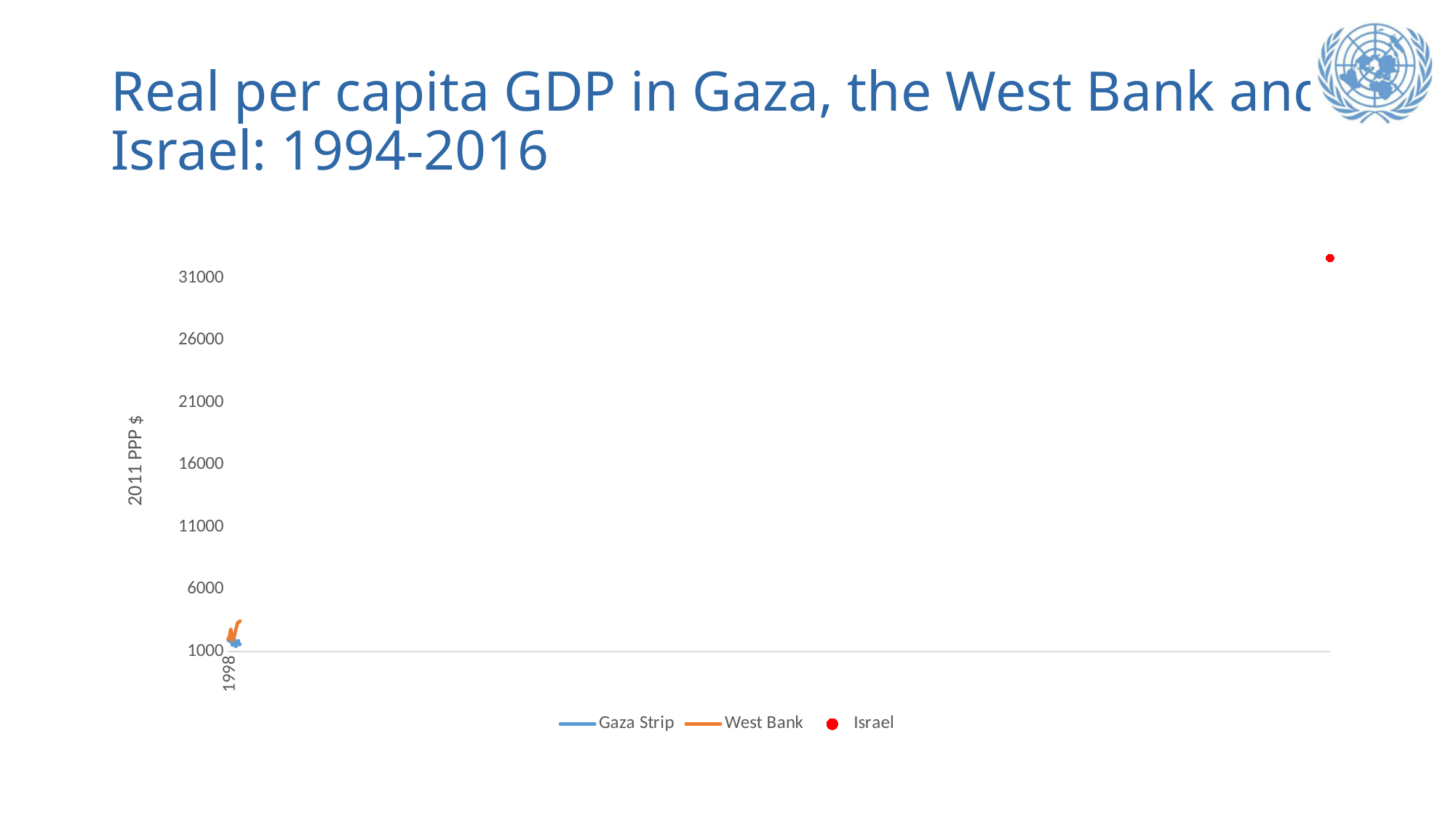
Which is larger, the plotted value for Israel or the plotted values for the West Bank? Israel Are the plotted values for the West Bank greater or less than 6000? less What is the highest tick value shown on the vertical axis? 31000 Is the plotted value for Israel greater or less than 26000? greater What is the label on the vertical axis? 2011 PPP $ Are the plotted values for the Gaza Strip greater or less than 6000? less How many series does the legend list? 3 Which series are listed in the legend? Gaza Strip, West Bank, Israel Which series reaches the highest value on the chart? Israel Which is larger, the plotted value for Israel or the plotted values for the Gaza Strip? Israel